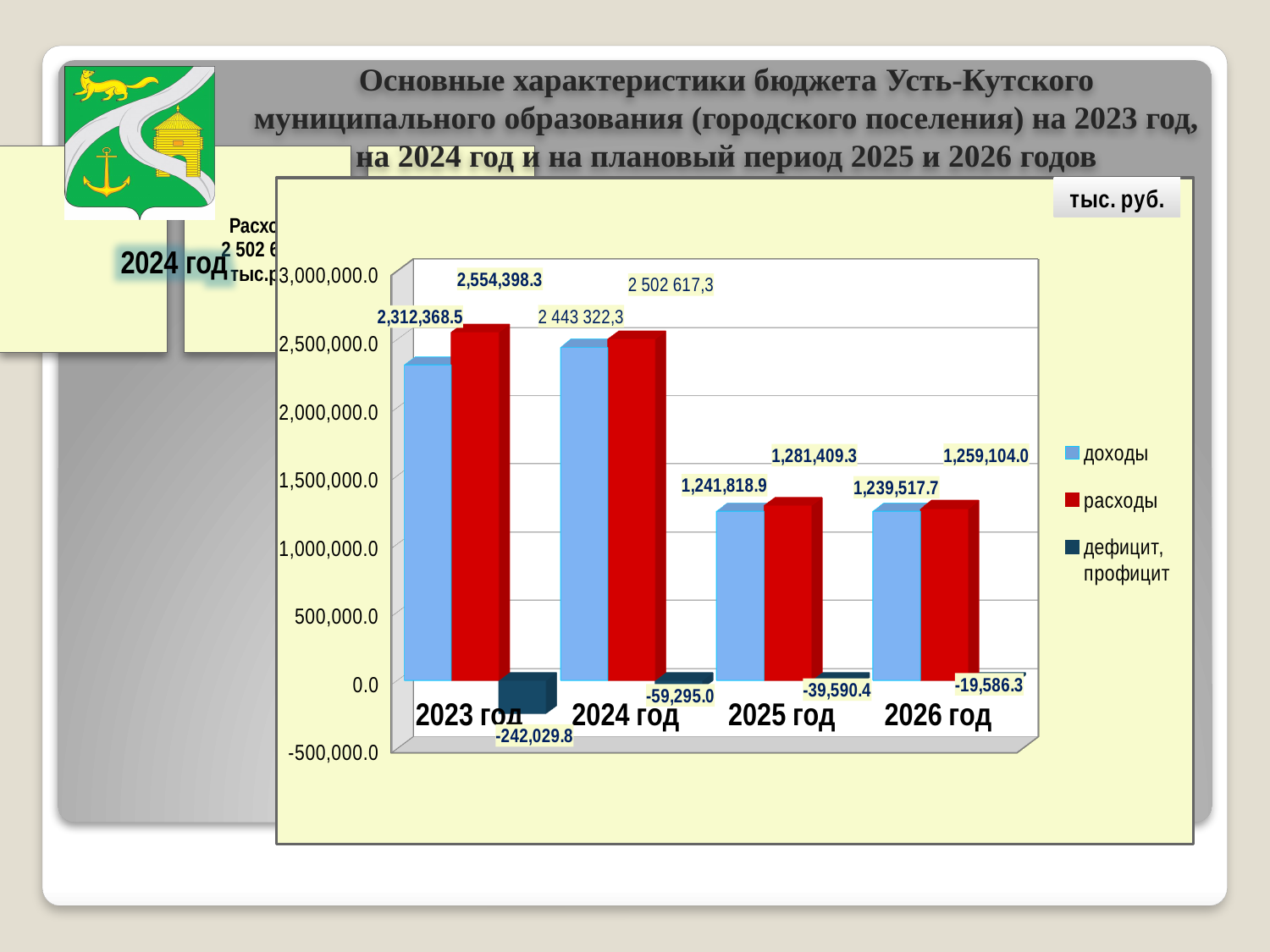
What is the value of дефицит, профицит for 2026 год? -19,586.3 How many series does the legend list? 3 Which year has the highest расходы value? 2023 год For 2023 год, which is larger: доходы or расходы? расходы How many years are shown on the x axis? 4 What is the value of доходы for 2023 год? 2,312,368.5 What is the value of расходы for 2025 год? 1,281,409.3 Is the value of доходы for 2024 год greater or less than 2,000,000.0? greater What is the value of расходы for 2024 год? 2 502 617,3 What is the difference between расходы and доходы for 2025 год? 39,590.4 Which year has the lowest (most negative) дефицит, профицит value? 2023 год What kind of chart is shown on the slide? bar chart